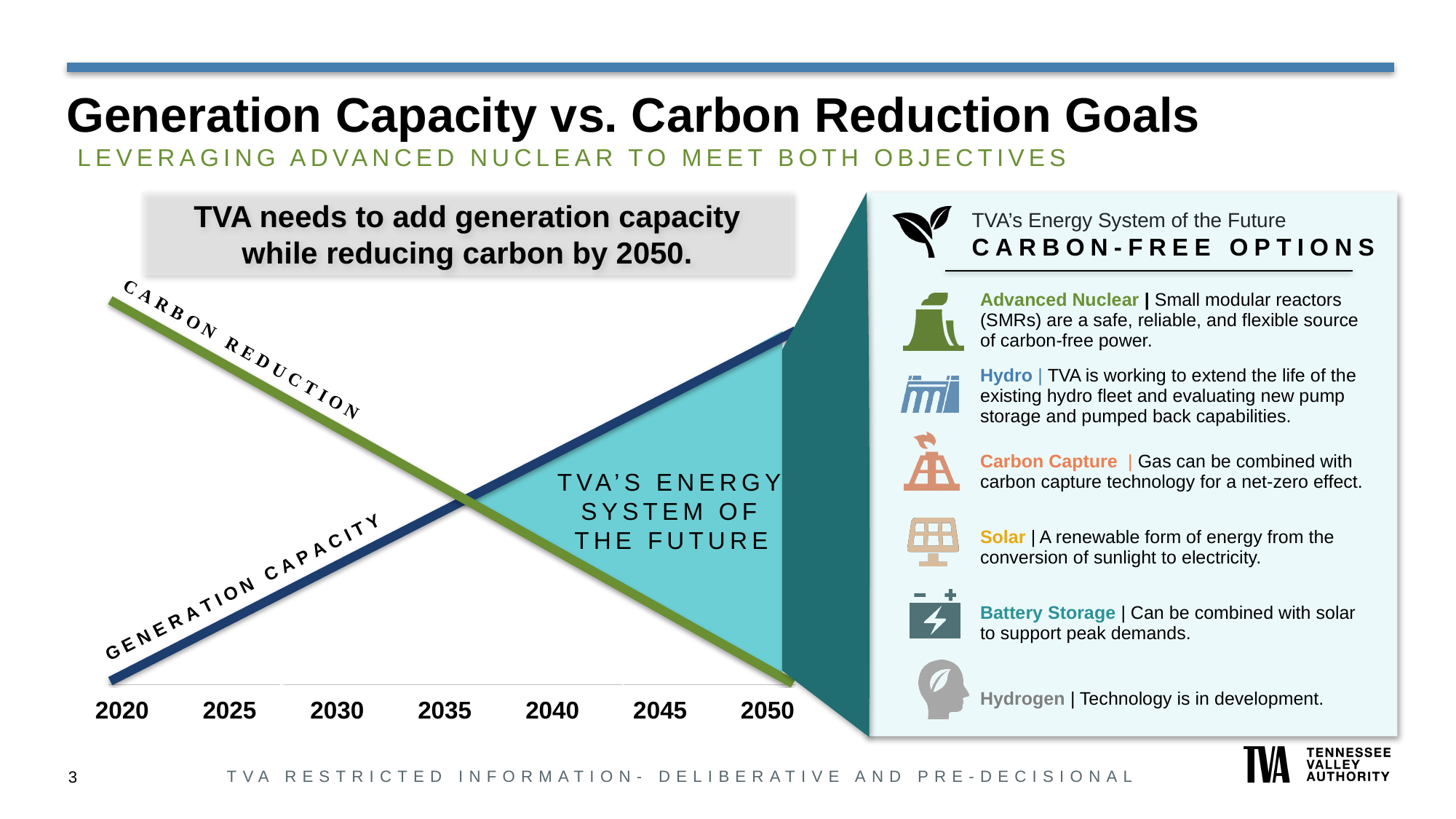
How many year labels are shown on the x axis of the chart? 7 What are the two lines on the chart labelled? Carbon Reduction and Generation Capacity What is the interval between consecutive year labels on the x axis of the chart? 5 years What kind of chart is shown on the left of the slide? line chart In 2020, which line is higher on the chart, Carbon Reduction or Generation Capacity? Carbon Reduction What is the first year shown on the x axis of the chart? 2020 Does the Generation Capacity line rise or fall from 2020 to 2050? rise Between which two x-axis years do the Carbon Reduction and Generation Capacity lines cross? 2035 and 2040 Does the Carbon Reduction line rise or fall from 2020 to 2050? fall How many lines are plotted on the chart? 2 What is the last year shown on the x axis of the chart? 2050 In 2050, which line is higher on the chart, Carbon Reduction or Generation Capacity? Generation Capacity